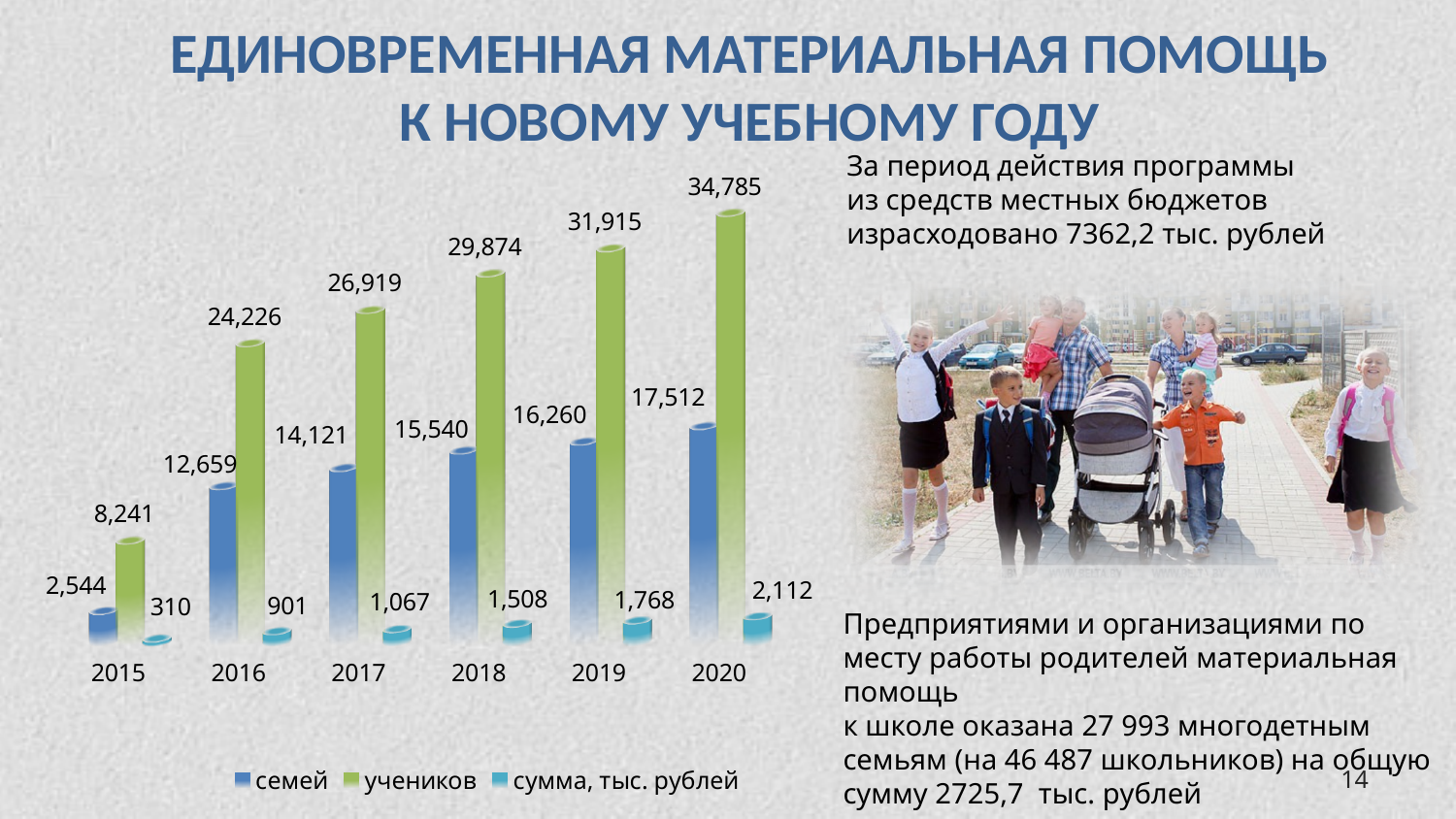
What is the value for "семей" in 2017? 14,121 Do the values for "учеников" rise or fall from 2015 to 2020? rise How many years are shown on the x axis of the chart? 6 What is the value for "сумма, тыс. рублей" in 2018? 1,508 What is the difference between the "учеников" values for 2020 and 2019? 2,870 What is the difference between the "семей" values for 2016 and 2015? 10,115 What is the value for "учеников" in 2020? 34,785 In which year is the value for "учеников" the lowest? 2015 Which is larger: the "сумма, тыс. рублей" value for 2019 or for 2017? 2019 In which year is the value for "семей" the highest? 2020 What kind of chart is shown on the slide? bar chart How many series does the chart legend list? 3